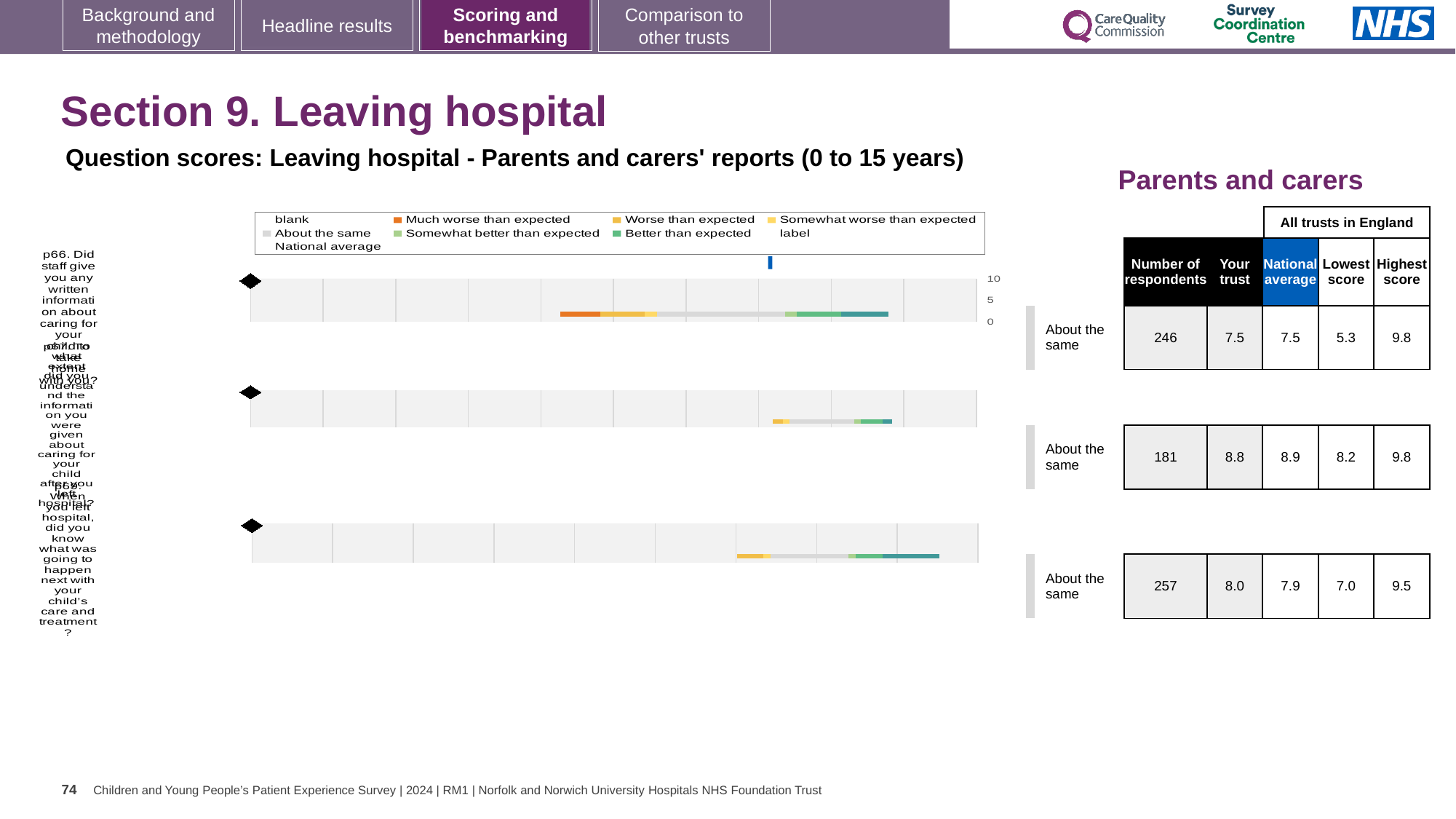
For the first question (p66), what is the difference between the highest score and the lowest score? 4.5 Which of the three questions has the largest number of respondents? p68 (257) In the chart legend, what colour represents 'Much worse than expected'? orange For the third question (p68), which is larger: the 'Your trust' score or the national average? Your trust How many question-score charts are shown on the slide? 3 In the table next to the charts, what is the lowest score for the first question (p66)? 5.3 What is the highest value shown on the axis of the top chart? 10 In the table next to the charts, what is the highest score for the third question (p68)? 9.5 In the table next to the charts, what is the 'Your trust' score for the second question (p67)? 8.8 In the table next to the charts, what is the number of respondents for the first question (p66)? 246 What kind of chart is used for the three question-score charts on the slide? bar chart What benchmark category is shown beside each of the three charts? About the same